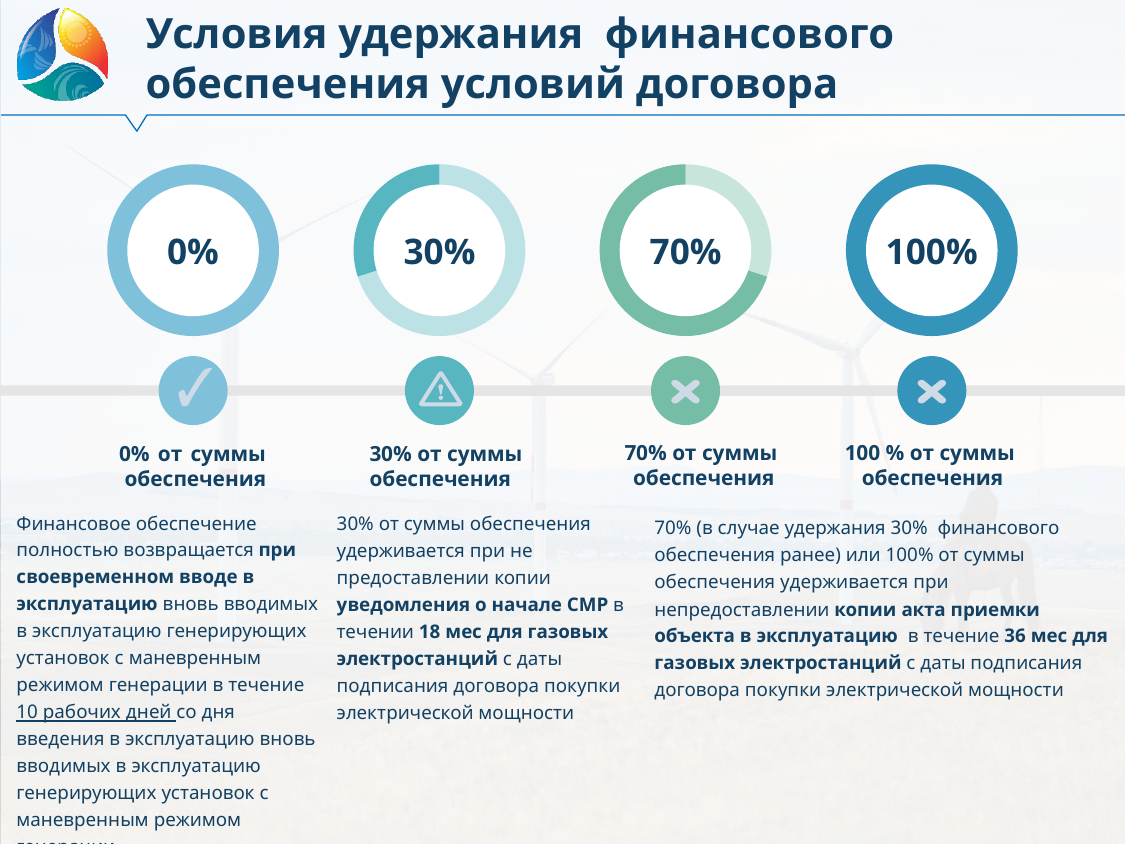
Which ring chart shows the lowest percentage? The leftmost one, 0% What percentage is shown in the first (leftmost) ring chart? 0% What percentage is shown in the second ring chart from the left? 30% Which ring chart shows the highest percentage? The rightmost one, 100% What kind of chart is used to display the percentages on the slide? Doughnut (ring) chart What is the difference between the percentages in the third and second ring charts? 40% How many ring charts are shown on the slide? 4 Which icon appears below the 0% ring chart? A check mark Do the percentages in the ring charts increase or decrease from left to right? Increase What is the difference between the percentages in the fourth and third ring charts? 30% What percentage is shown in the rightmost ring chart? 100% What percentage is shown in the third ring chart from the left? 70%